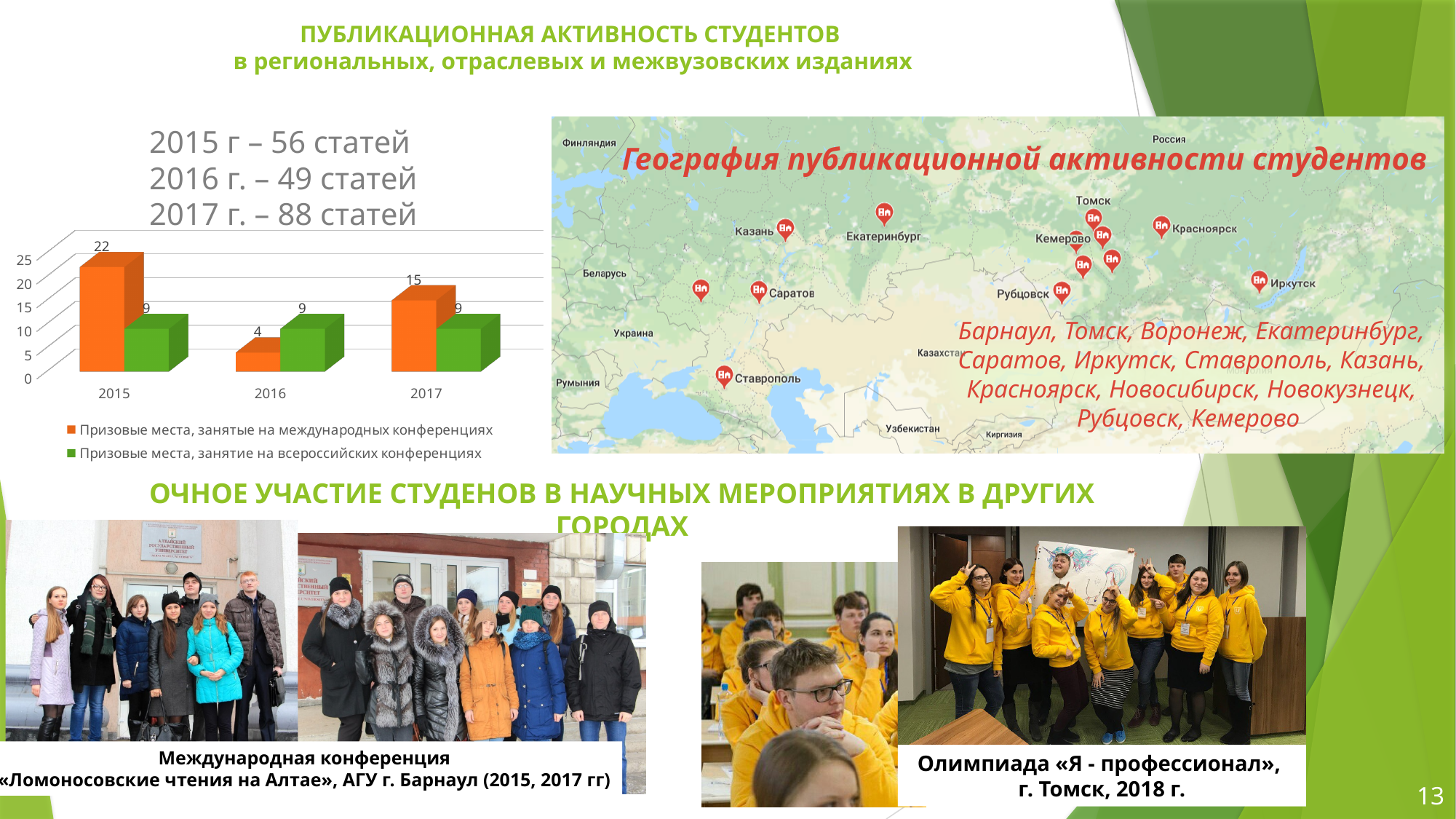
What is the difference between the 2015 and 2017 values for 'Призовые места, занятые на международных конференциях'? 7 In 2016, which series has the larger value: international conferences or all-Russian conferences? Призовые места, занятие на всероссийских конференциях What is the value for 'Призовые места, занятие на всероссийских конференциях' in 2016? 9 In which year is the value for 'Призовые места, занятые на международных конференциях' highest? 2015 Which colour represents 'Призовые места, занятые на международных конференциях' in the chart? orange How many years are shown on the x axis of the chart? 3 What is the value for 'Призовые места, занятые на международных конференциях' in 2017? 15 In which year is the value for 'Призовые места, занятые на международных конференциях' lowest? 2016 What is the value for 'Призовые места, занятые на международных конференциях' in 2016? 4 What kind of chart is shown on the slide? bar chart What is the value for 'Призовые места, занятые на международных конференциях' in 2015? 22 How many series does the chart legend list? 2